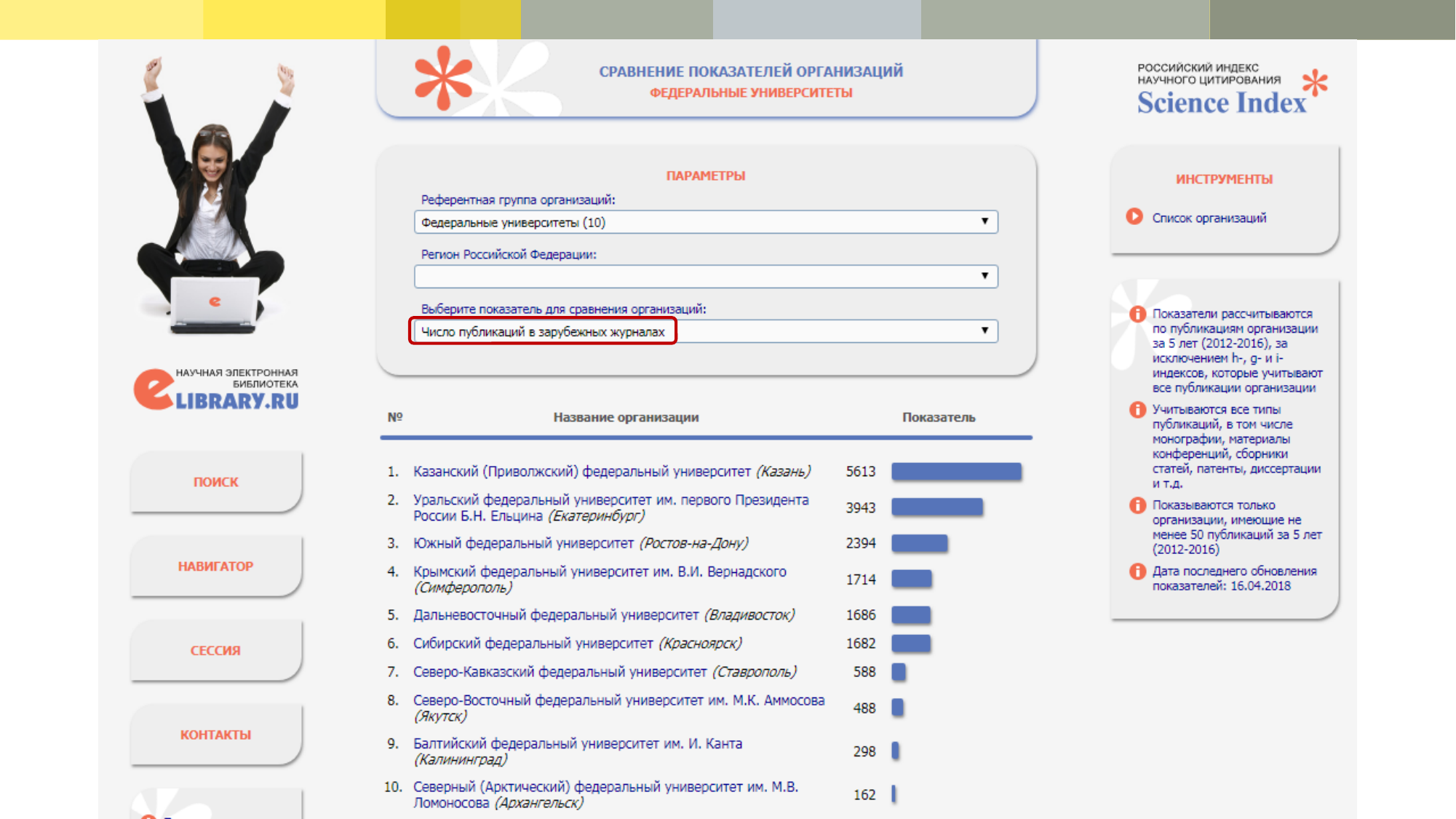
What value is shown for Южный федеральный университет (Ростов-на-Дону)? 2394 What is the difference between the values for Казанский (Приволжский) федеральный университет and Уральский федеральный университет? 1670 Which has a larger value: Крымский федеральный университет им. В.И. Вернадского or Дальневосточный федеральный университет? Крымский федеральный университет им. В.И. Вернадского Which organization has the lowest value in the chart? Северный (Арктический) федеральный университет им. М.В. Ломоносова (Архангельск) What is the difference between the values for Северо-Кавказский федеральный университет (Ставрополь) and Северо-Восточный федеральный университет им. М.К. Аммосова (Якутск)? 100 What kind of chart is shown on the slide? Bar chart Which indicator is selected for comparing the organizations? Число публикаций в зарубежных журналах Which organization has the highest value in the chart? Казанский (Приволжский) федеральный университет (Казань) What value is shown for Казанский (Приволжский) федеральный университет (Казань)? 5613 What value is shown for Балтийский федеральный университет им. И. Канта (Калининград)? 298 What value is shown for Сибирский федеральный университет (Красноярск)? 1682 How many organizations are listed in the chart? 10